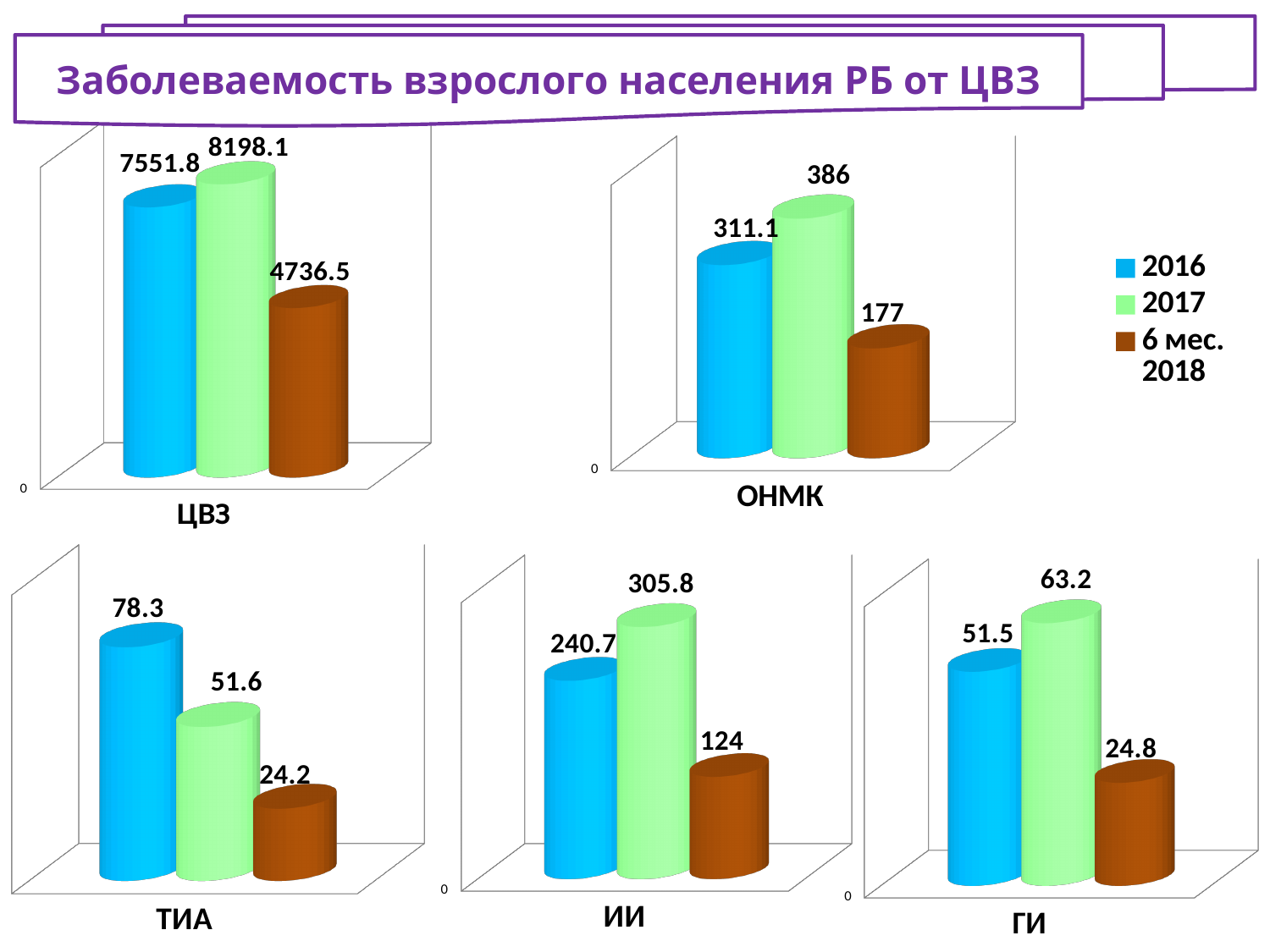
In the ТИА chart, which series has the lowest value? 6 мес. 2018 In the ОНМК chart, which is larger, the value for 2016 or the value for 2017? 2017 In the ТИА chart, what is the value for 2016? 78.3 In the ЦВЗ chart, what is the difference between the 2017 and 2016 values? 646.3 In the ИИ chart, what is the value for 2017? 305.8 In the ЦВЗ chart, what is the value for 2017? 8198.1 What kind of chart is the ИИ chart? bar chart In the ГИ chart, which series has the highest value? 2017 How many series does the legend list? 3 In the ОНМК chart, what is the value for 6 мес. 2018? 177 In the ГИ chart, what is the difference between the 2016 and 6 мес. 2018 values? 26.7 In the ТИА chart, is the value for 2016 greater or less than the value for 2017? greater